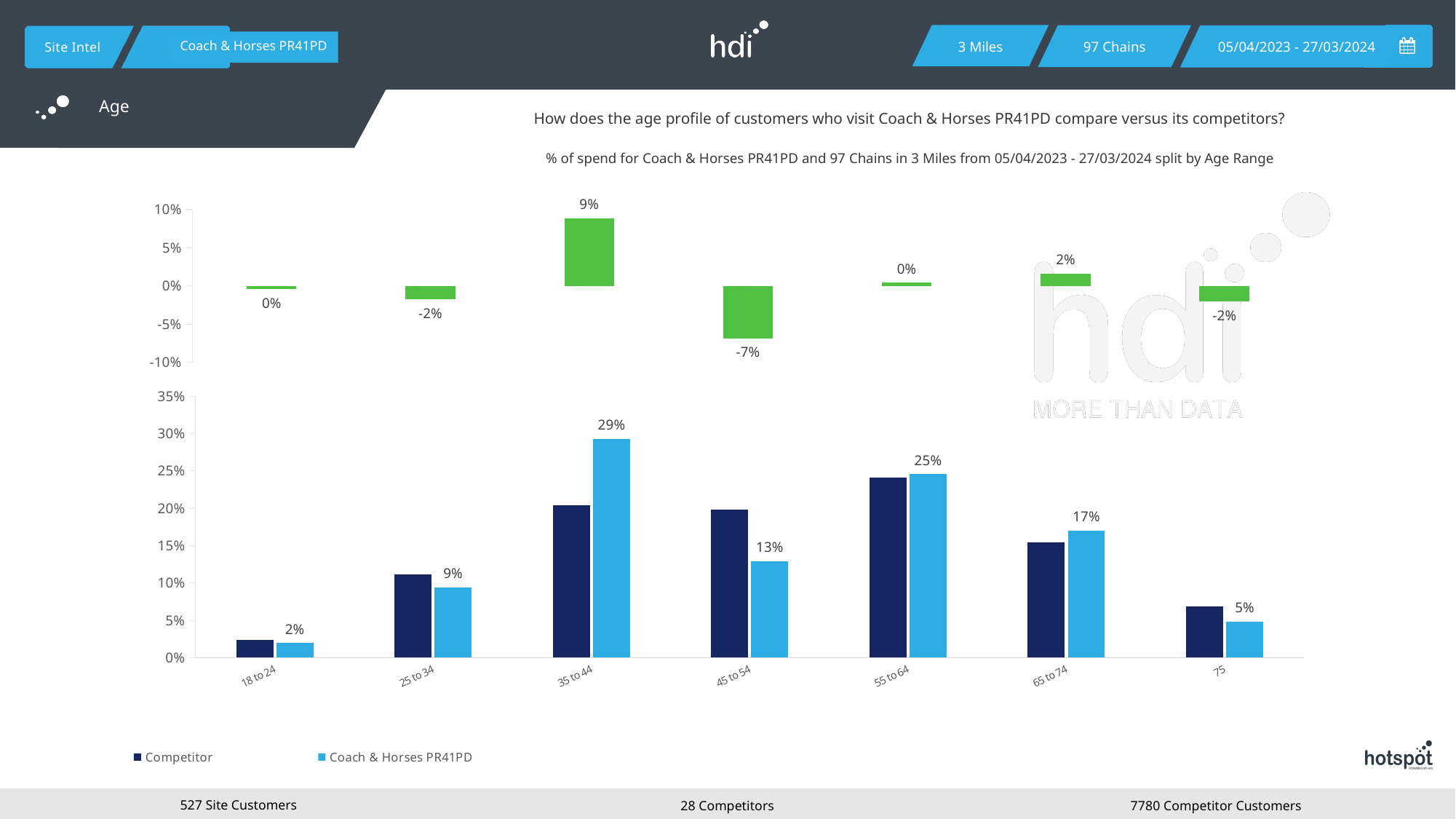
In the bottom bar chart, which age range has the highest value for Coach & Horses PR41PD? 35 to 44 In the top green chart, which age range has the highest value? 35 to 44 How many series does the legend of the bottom chart list? 2 In the bottom bar chart, is the Competitor value for 35 to 44 greater or less than 15%? greater In the bottom bar chart, what is the difference between the Coach & Horses PR41PD values for 35 to 44 and 45 to 54? 16 percentage points In the bottom bar chart, for the 45 to 54 age range, which series has the larger value: Competitor or Coach & Horses PR41PD? Competitor How many age range categories are shown on the x axis of the bottom bar chart? 7 In the bottom bar chart, what is the value for Coach & Horses PR41PD in the 65 to 74 age range? 17% In the bottom bar chart, which age range has the lowest value for Coach & Horses PR41PD? 18 to 24 What type of chart is the bottom chart on the slide? bar chart In the top green chart, what is the value for the 45 to 54 age range? -7% In the bottom bar chart, what is the value for Coach & Horses PR41PD in the 35 to 44 age range? 29%